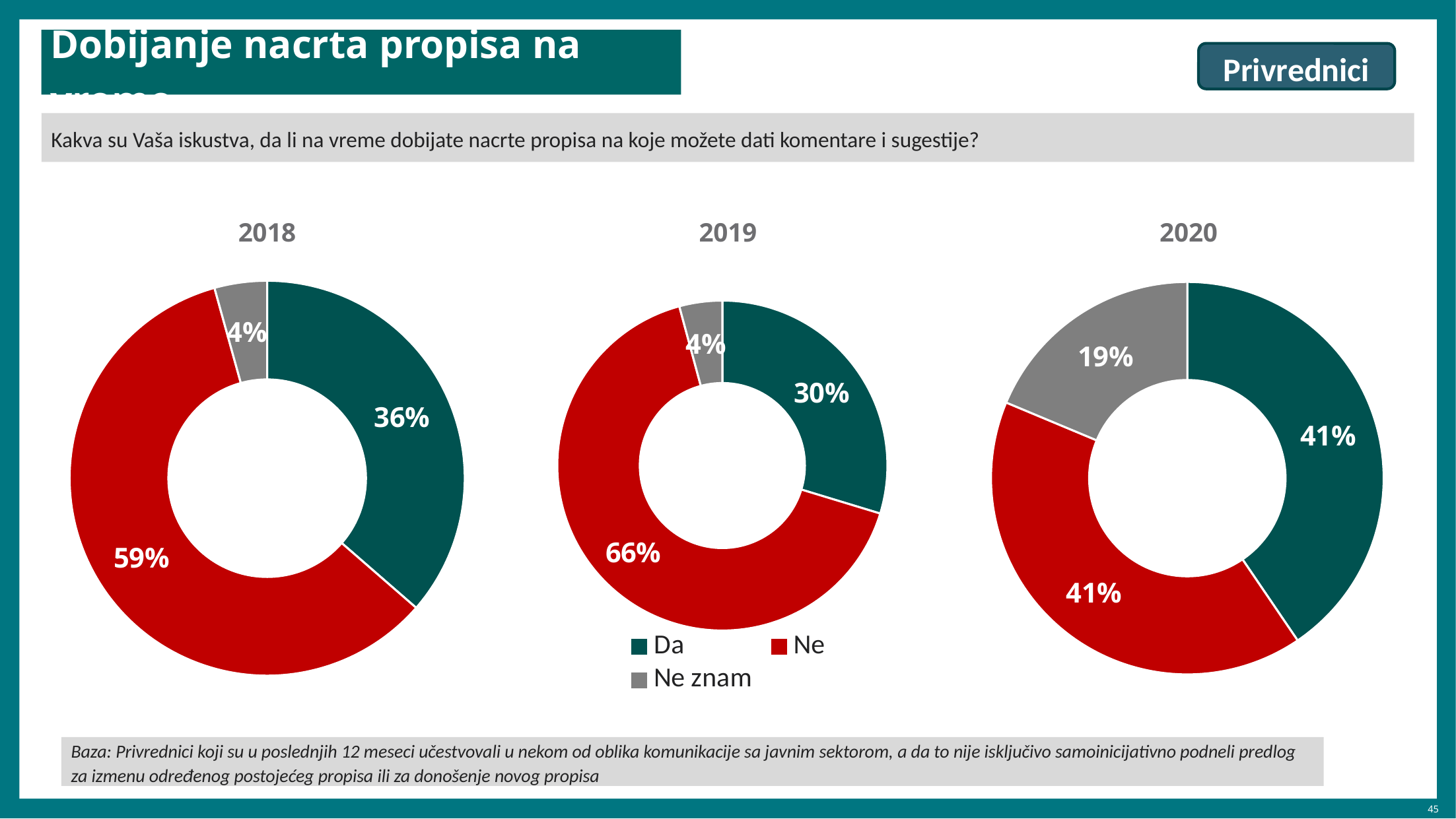
How many charts are shown on the slide? 3 In the 2020 chart, what is the combined share of "Da" and "Ne"? 82% In the 2018 chart, what percentage answered "Ne"? 59% Which colour represents "Ne" in the legend? Red In the 2019 chart, what percentage answered "Da"? 30% How many series does the legend list? 3 In the 2020 chart, what percentage answered "Ne znam"? 19% In the 2019 chart, what is the difference between the "Ne" and "Da" shares? 36 percentage points In the 2020 chart, is the "Da" share larger than the "Ne znam" share? Yes, Da In the 2018 chart, which answer has the largest share? Ne In the 2019 chart, which answer has the smallest share? Ne znam What kind of chart is used for the 2018 data? Doughnut (pie) chart